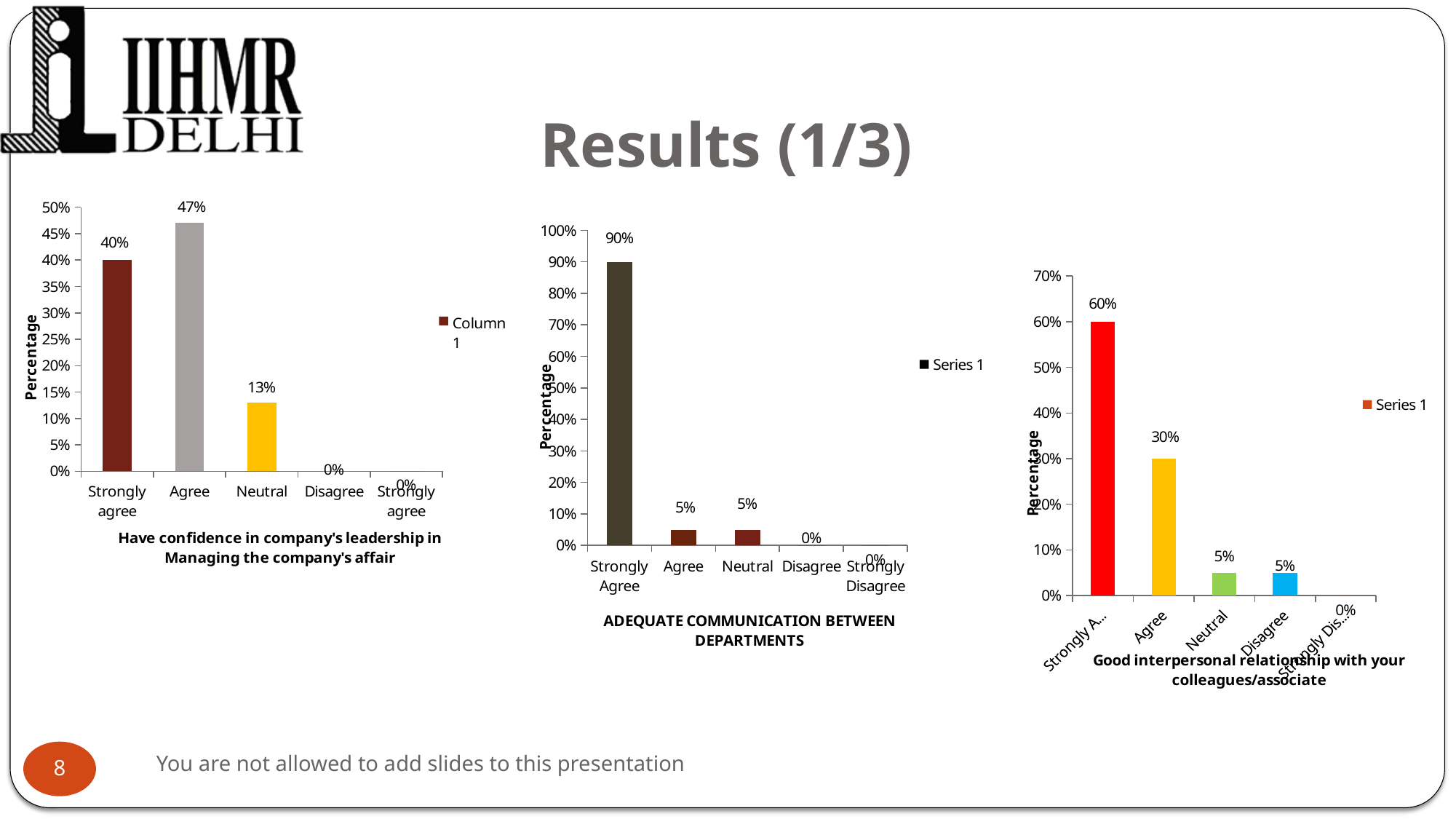
In the chart titled "Have confidence in company's leadership in Managing the company's affair", what is the difference between the Agree and Strongly agree values? 7% In the chart titled "ADEQUATE COMMUNICATION BETWEEN DEPARTMENTS", what is the value for Strongly Agree? 90% In the chart titled "ADEQUATE COMMUNICATION BETWEEN DEPARTMENTS", how many categories are shown on the x axis? 5 In the chart titled "Good interpersonal relationship with your colleagues/associate", what is the value for Agree? 30% In the chart titled "ADEQUATE COMMUNICATION BETWEEN DEPARTMENTS", what is the difference between the Strongly Agree and Agree values? 85% In the chart titled "Have confidence in company's leadership in Managing the company's affair", which category has the highest value? Agree In the chart titled "Have confidence in company's leadership in Managing the company's affair", what is the value for Agree? 47% In the chart titled "ADEQUATE COMMUNICATION BETWEEN DEPARTMENTS", what is the value for Disagree? 0% In the chart titled "Good interpersonal relationship with your colleagues/associate", is the value for Agree larger or smaller than the value for Neutral? larger In the chart titled "Have confidence in company's leadership in Managing the company's affair", what is the value for Neutral? 13% In the chart titled "Good interpersonal relationship with your colleagues/associate", what kind of chart is shown? bar chart In the chart titled "Good interpersonal relationship with your colleagues/associate", how many series does the legend list? 1